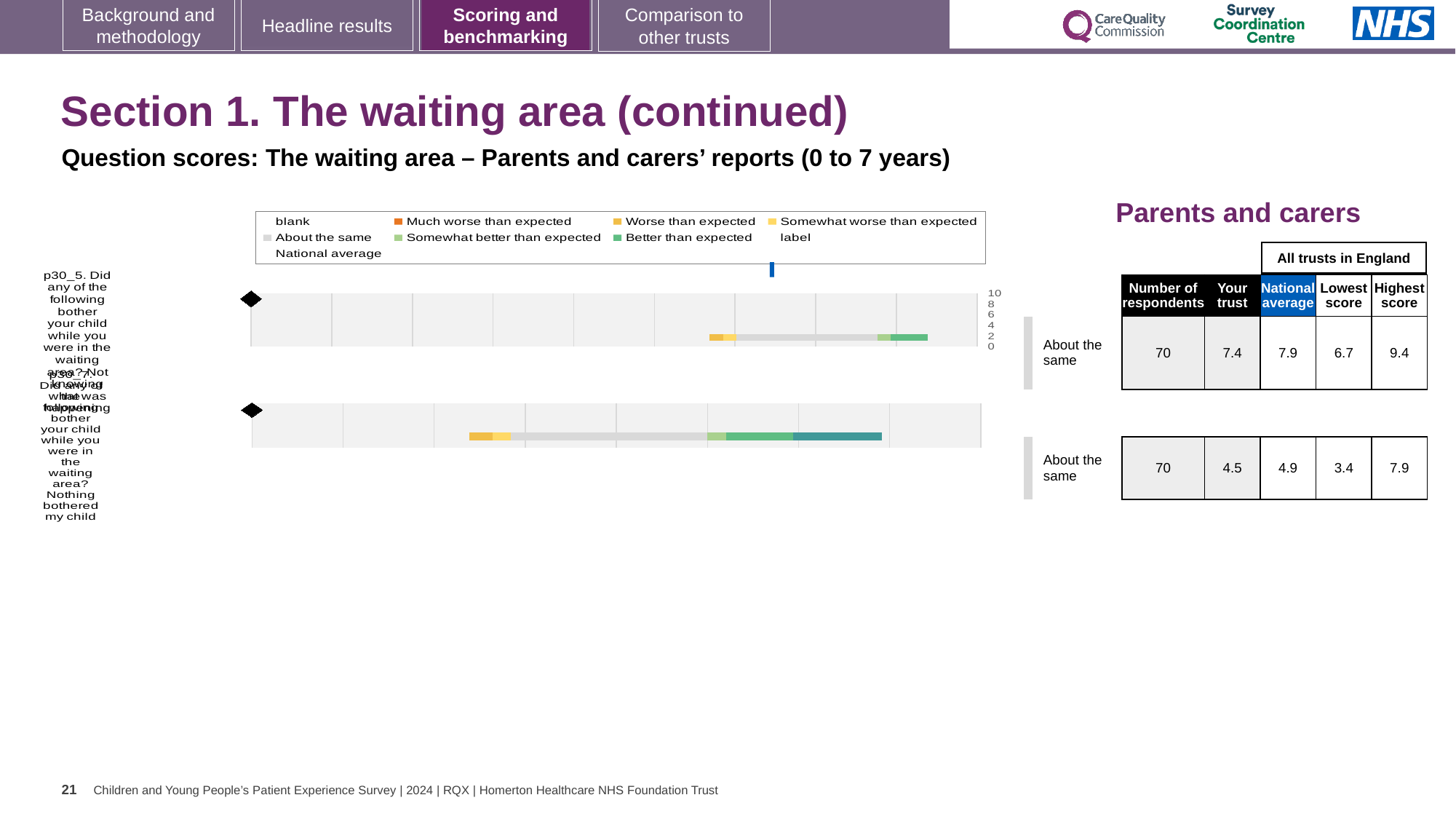
What is the difference between the highest score (9.4) and the lowest score (6.7) across all trusts in England for question p30_5? 2.7 What kind of chart is shown on the slide? bar chart How many questions (bars) are plotted in the chart? 2 What is the 'Your trust' score for question p30_7 (Nothing bothered my child)? 4.5 Which question has the higher 'Your trust' score, p30_5 or p30_7? p30_5 What is the national average score for question p30_5? 7.9 What is the 'Your trust' score for question p30_5 (Did any of the following bother your child while you were in the waiting area? Not knowing what was happening)? 7.4 Is the 'Your trust' score for question p30_5 greater or less than 6 on the chart's axis? greater How many respondents answered question p30_5? 70 What benchmark category is shown for both questions in the chart? About the same What is the national average score for question p30_7? 4.9 By how much does the national average (4.9) exceed the 'Your trust' score (4.5) for question p30_7? 0.4